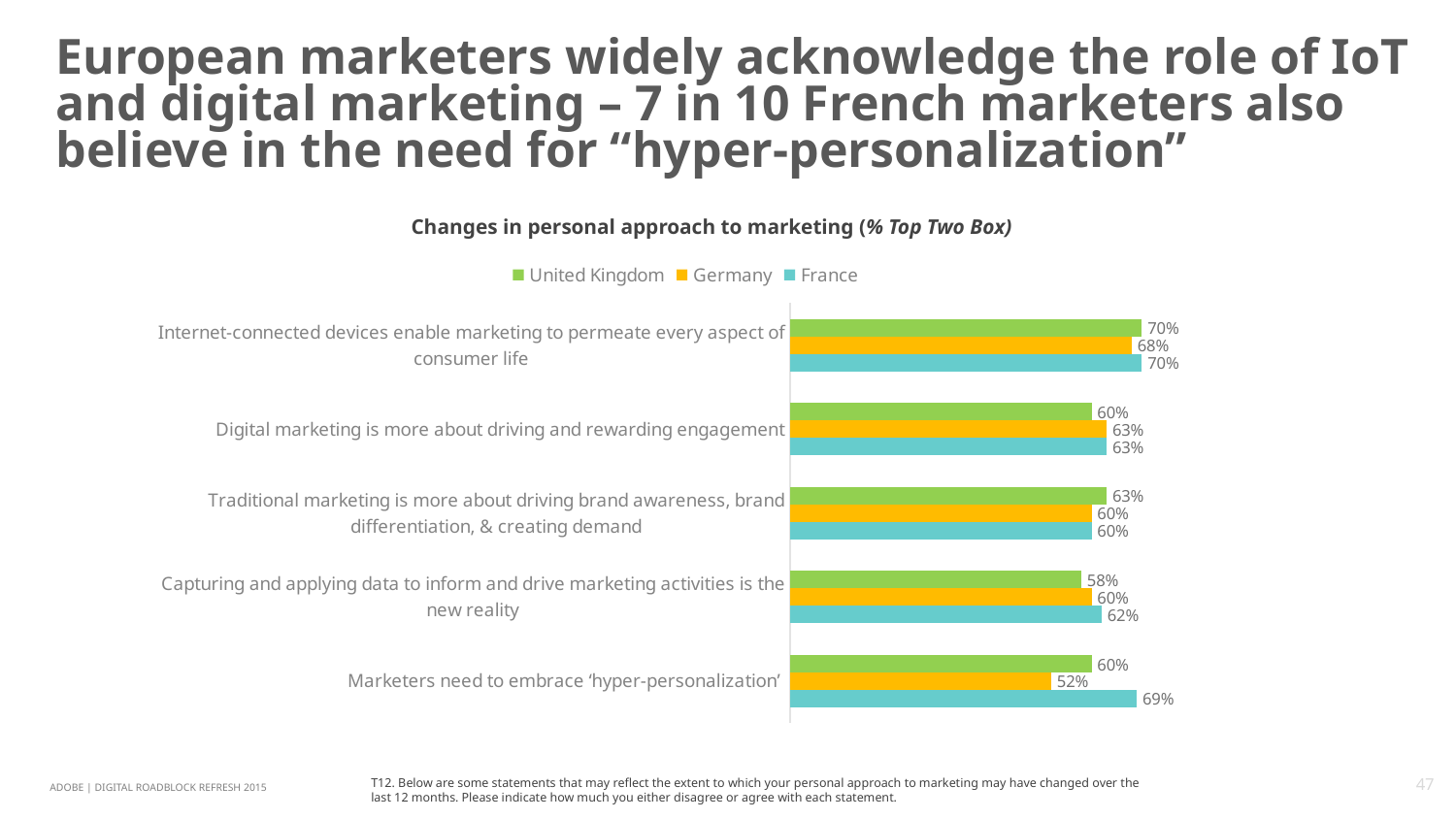
What is the value for Germany for 'Digital marketing is more about driving and rewarding engagement'? 63% How many series does the legend list? 3 What type of chart is shown on the slide? Bar chart What is the title of the chart? Changes in personal approach to marketing (% Top Two Box) What is the value for the United Kingdom for 'Capturing and applying data to inform and drive marketing activities is the new reality'? 58% What is the value for France for 'Marketers need to embrace hyper-personalization'? 69% How many statements (categories) are shown in the chart? 5 Which statement has the highest value for the United Kingdom? Internet-connected devices enable marketing to permeate every aspect of consumer life What is the difference between the France and Germany values for 'Marketers need to embrace hyper-personalization'? 17 percentage points For 'Capturing and applying data to inform and drive marketing activities is the new reality', which country has the larger value, France or the United Kingdom? France What is the value for Germany for 'Internet-connected devices enable marketing to permeate every aspect of consumer life'? 68% Which statement has the lowest value for Germany? Marketers need to embrace 'hyper-personalization'